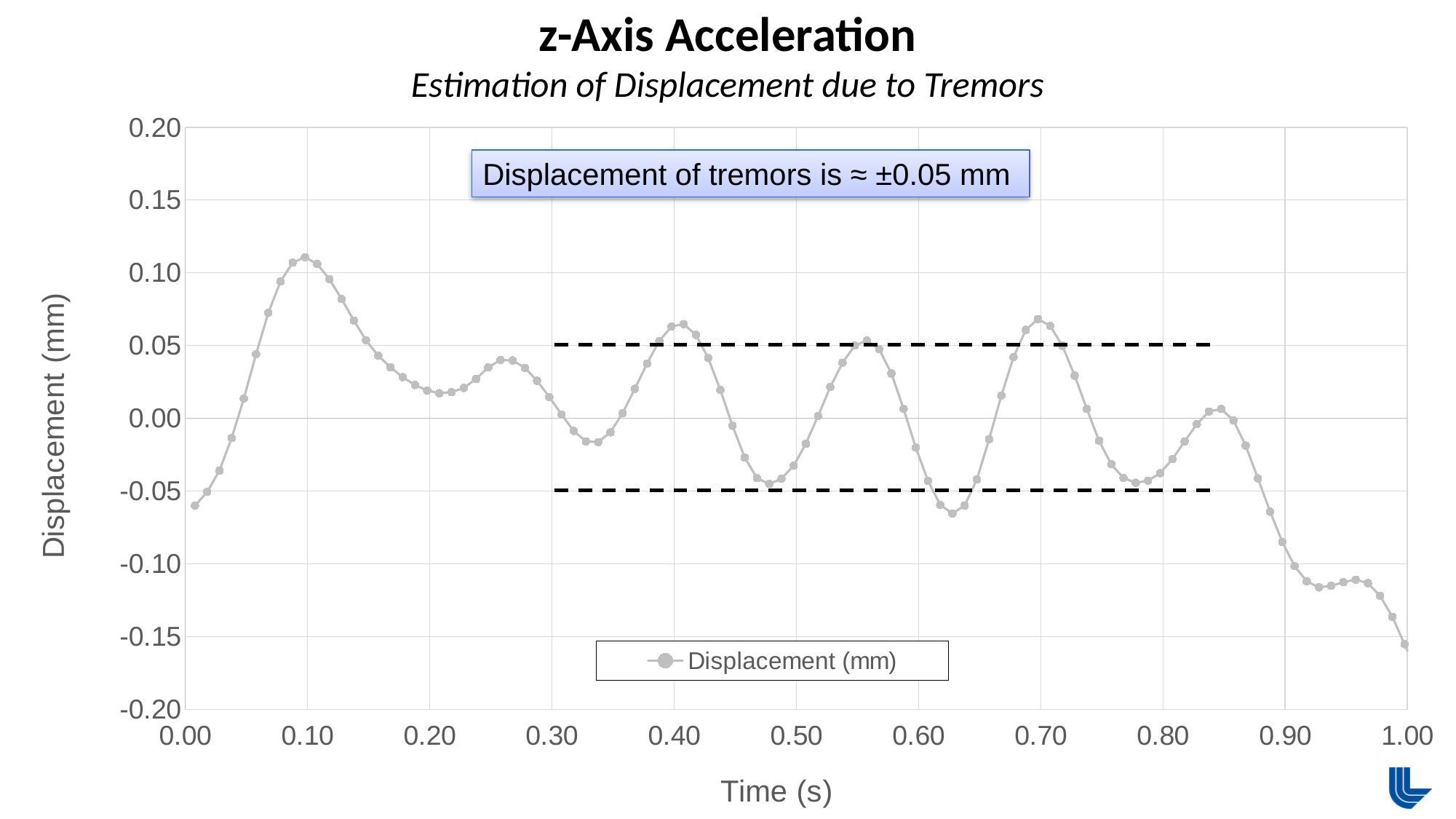
Is the displacement value at 0.80 s greater or less than 0.00? less Is the displacement value at 0.20 s greater or less than 0.00? greater Is the displacement value at 1.00 s greater or less than -0.10? less What kind of chart is shown on the slide? line chart What is the name of the series shown in the legend? Displacement (mm) How many series does the legend list? 1 Do the displacement values rise or fall between 0.90 s and 1.00 s? fall According to the annotation box on the chart, what is the approximate displacement of tremors? ≈ ±0.05 mm Do the displacement values rise or fall between 0.00 s and 0.10 s? rise